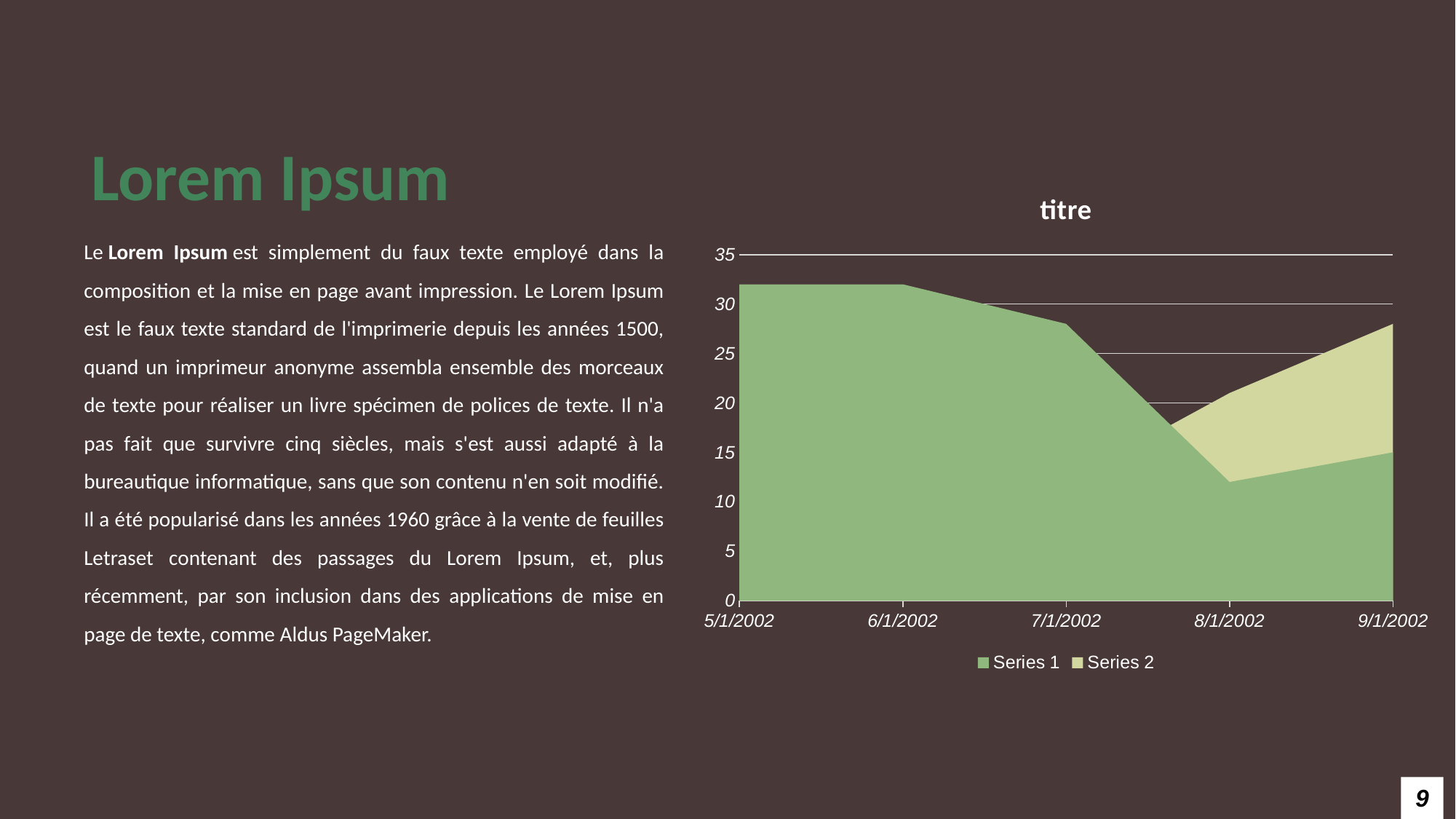
Is the value of Series 1 at 7/1/2002 greater or less than 25? greater Which is larger for Series 1: the value at 7/1/2002 or at 8/1/2002? 7/1/2002 What kind of chart is shown on the slide? Area chart How many dates are shown on the x axis of the chart? 5 Is the value of Series 2 at 9/1/2002 greater or less than 25? greater What is the title of the chart? titre Does Series 1 rise or fall between 6/1/2002 and 8/1/2002? Fall Is the value of Series 1 at 8/1/2002 greater or less than 15? less How many series does the chart legend list? 2 At which date does Series 1 reach its lowest value? 8/1/2002